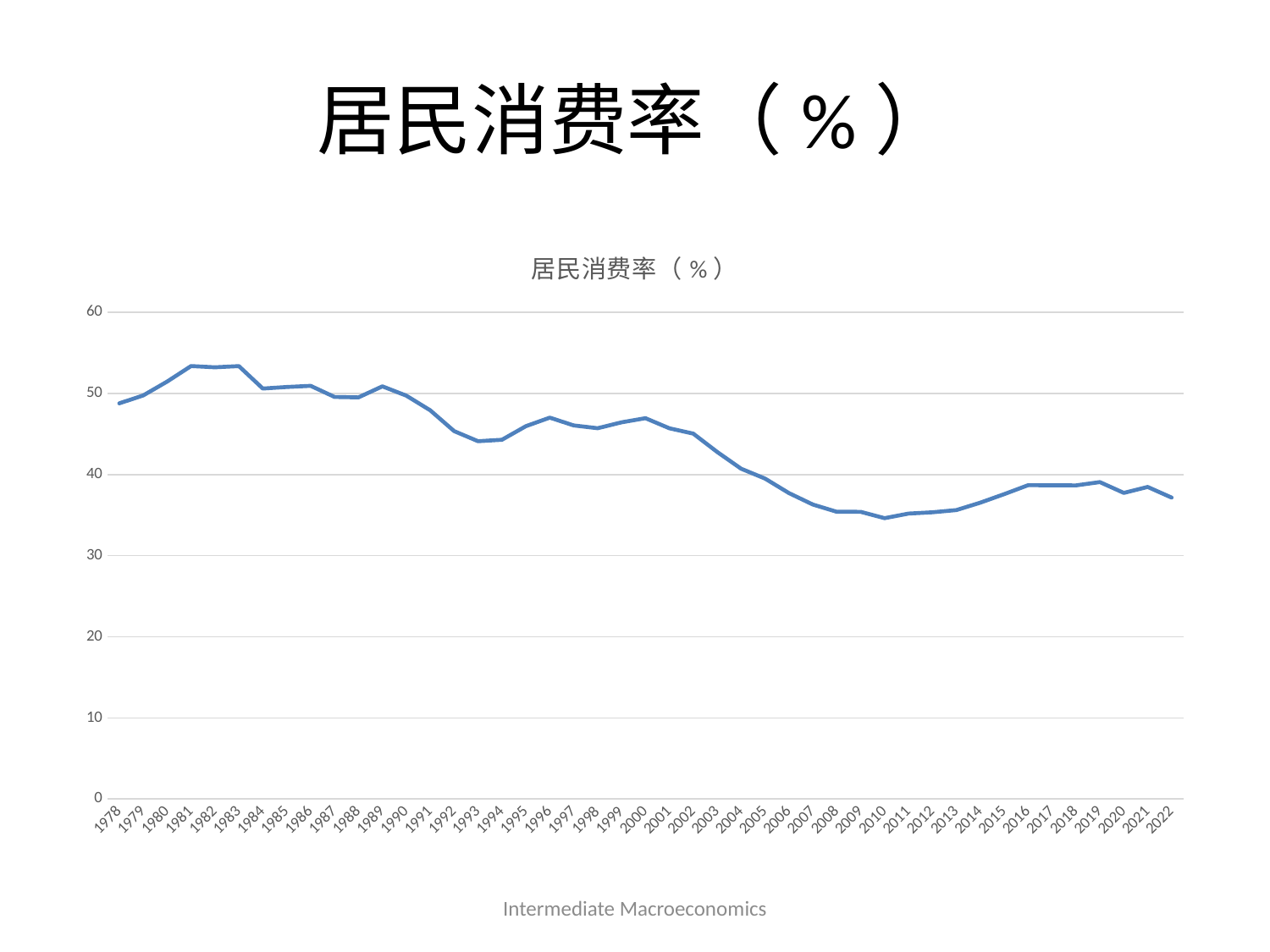
Is the value for 1981 greater or less than 50? greater Which is larger, the value for 1981 or the value for 2010? 1981 How many years are plotted along the x axis of the chart? 45 What is the title of the chart? 居民消费率（%） Is the value for 2022 greater or less than 40? less Is the value for 1978 greater or less than 40? greater What kind of chart is shown on the slide? line chart Which is larger, the value for 1996 or the value for 2005? 1996 Which year has the lowest value on the chart? 2010 Overall, does the value rise or fall from 1978 to 2022? fall